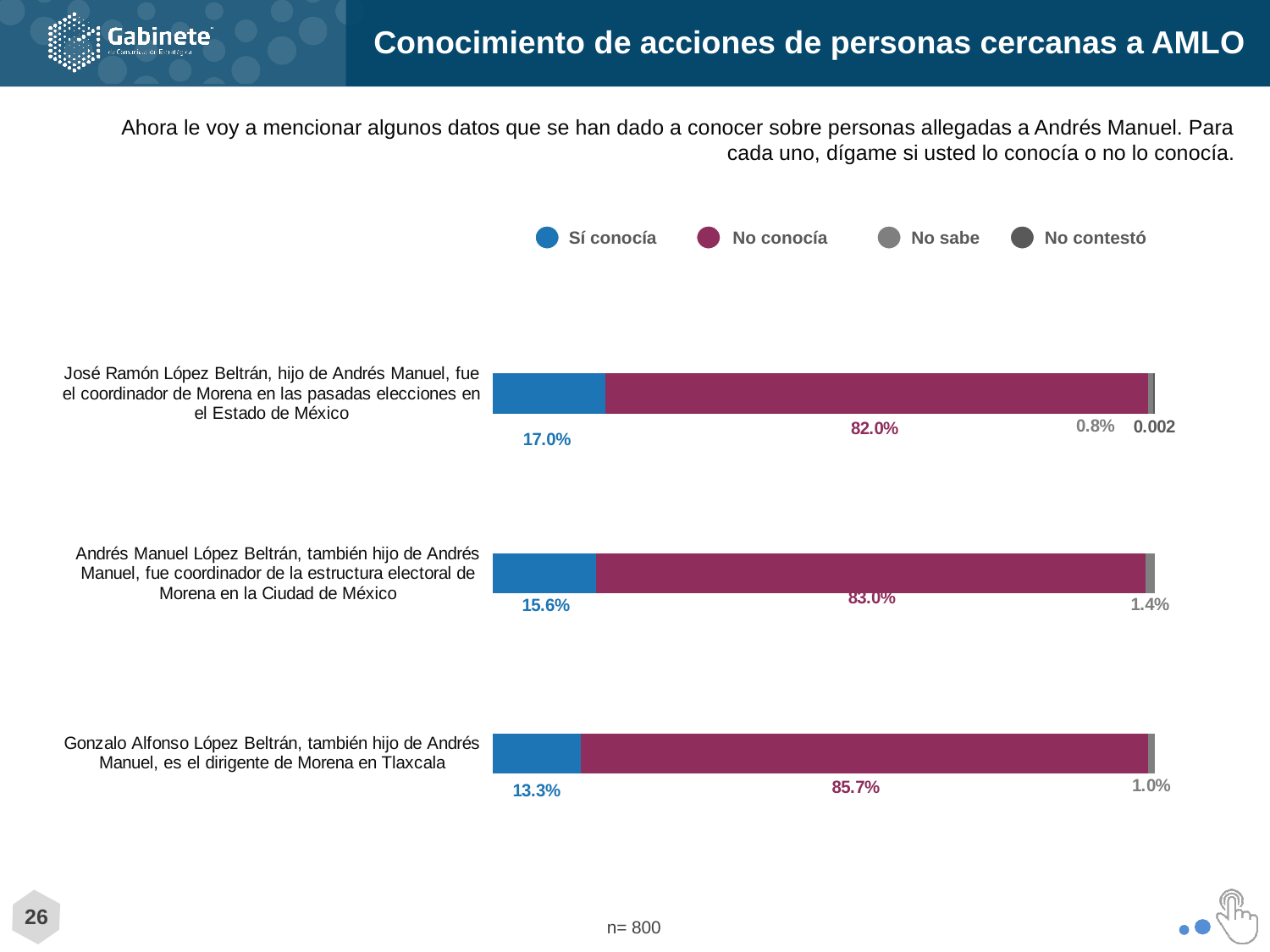
What type of chart is shown on the slide? Stacked horizontal bar chart What percentage of respondents said 'Sí conocía' for José Ramón López Beltrán, hijo de Andrés Manuel, fue el coordinador de Morena en las pasadas elecciones en el Estado de México? 17.0% How many statements (bars) are shown in the chart? 3 What is the 'No conocía' value for Andrés Manuel López Beltrán, también hijo de Andrés Manuel, fue coordinador de la estructura electoral de Morena en la Ciudad de México? 83.0% What is the difference in 'Sí conocía' percentage between José Ramón López Beltrán (17.0%) and Gonzalo Alfonso López Beltrán (13.3%)? 3.7 percentage points What is the 'No sabe' value for José Ramón López Beltrán, hijo de Andrés Manuel? 0.8% Which of the three statements has the lowest 'Sí conocía' percentage? Gonzalo Alfonso López Beltrán, también hijo de Andrés Manuel, es el dirigente de Morena en Tlaxcala Which of the three statements has the highest 'Sí conocía' percentage? José Ramón López Beltrán, hijo de Andrés Manuel, fue el coordinador de Morena en las pasadas elecciones en el Estado de México Which has a larger 'No conocía' value: the statement about José Ramón López Beltrán or the statement about Andrés Manuel López Beltrán? Andrés Manuel López Beltrán What is the 'Sí conocía' value for Gonzalo Alfonso López Beltrán, el dirigente de Morena en Tlaxcala? 13.3% How many response categories does the legend list? 4 What percentage of respondents said 'No conocía' for Gonzalo Alfonso López Beltrán, también hijo de Andrés Manuel, es el dirigente de Morena en Tlaxcala? 85.7%